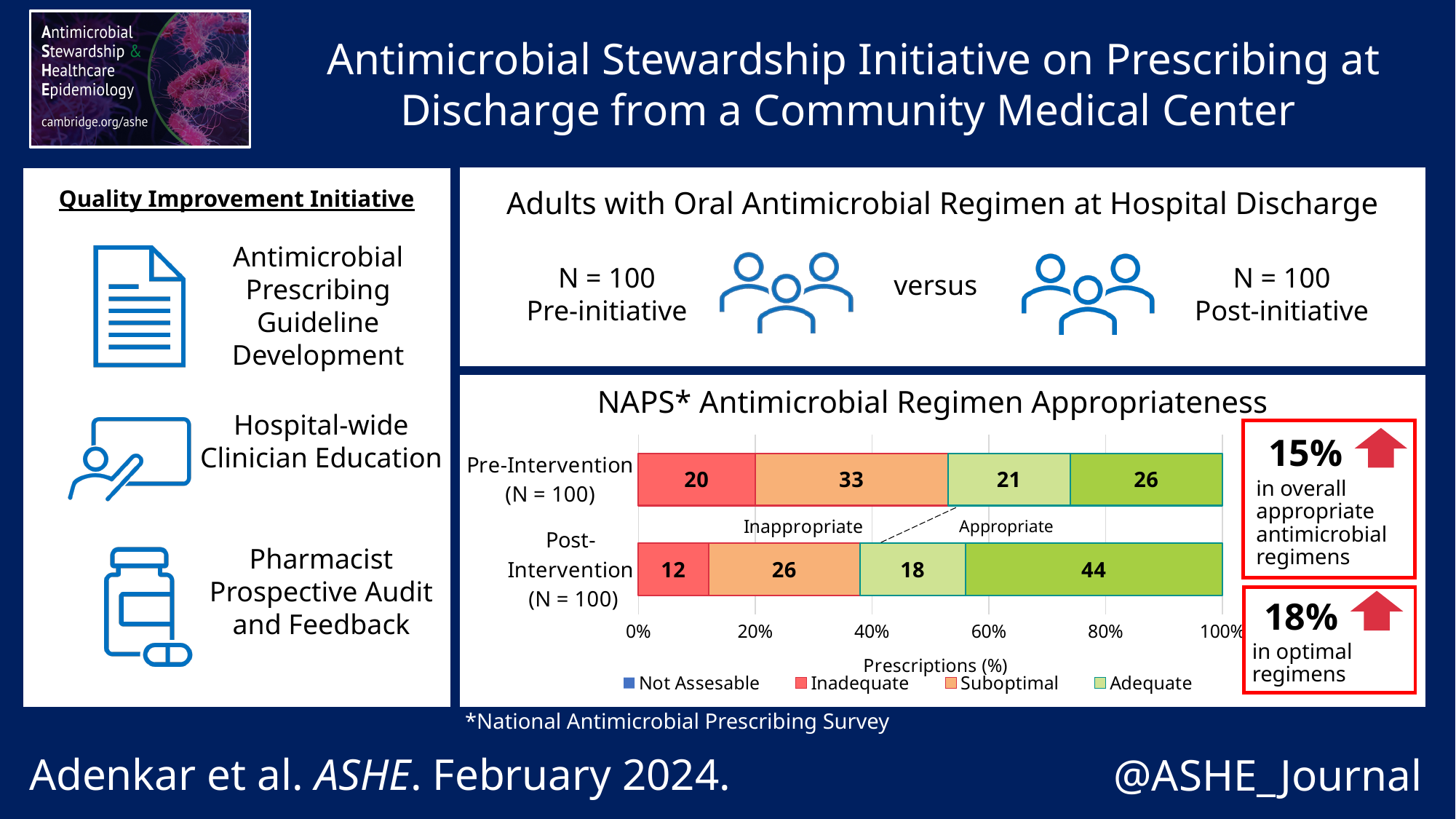
What kind of chart is shown under the title "NAPS* Antimicrobial Regimen Appropriateness"? Stacked bar chart In the NAPS* chart, what is the difference between the Inadequate values for Pre-Intervention and Post-Intervention? 8 In the NAPS* chart, which bar has the larger Suboptimal value, Pre-Intervention or Post-Intervention? Pre-Intervention In the NAPS* chart, what is the largest segment value in the Post-Intervention (N = 100) bar? 44 In the NAPS* chart, what is the Suboptimal value for Pre-Intervention (N = 100)? 33 In the NAPS* chart, what is the difference between the Suboptimal values for Pre-Intervention and Post-Intervention? 7 In the NAPS* chart, what is the Inadequate value for Pre-Intervention (N = 100)? 20 How many bars (categories) does the NAPS* Antimicrobial Regimen Appropriateness chart show? 2 In the NAPS* chart, what is the total of all segments in the Pre-Intervention (N = 100) bar? 100 How many series does the legend of the NAPS* Antimicrobial Regimen Appropriateness chart list? 4 In the NAPS* chart, what is the Suboptimal value for Post-Intervention (N = 100)? 26 In the NAPS* chart, what is the Inadequate value for Post-Intervention (N = 100)? 12